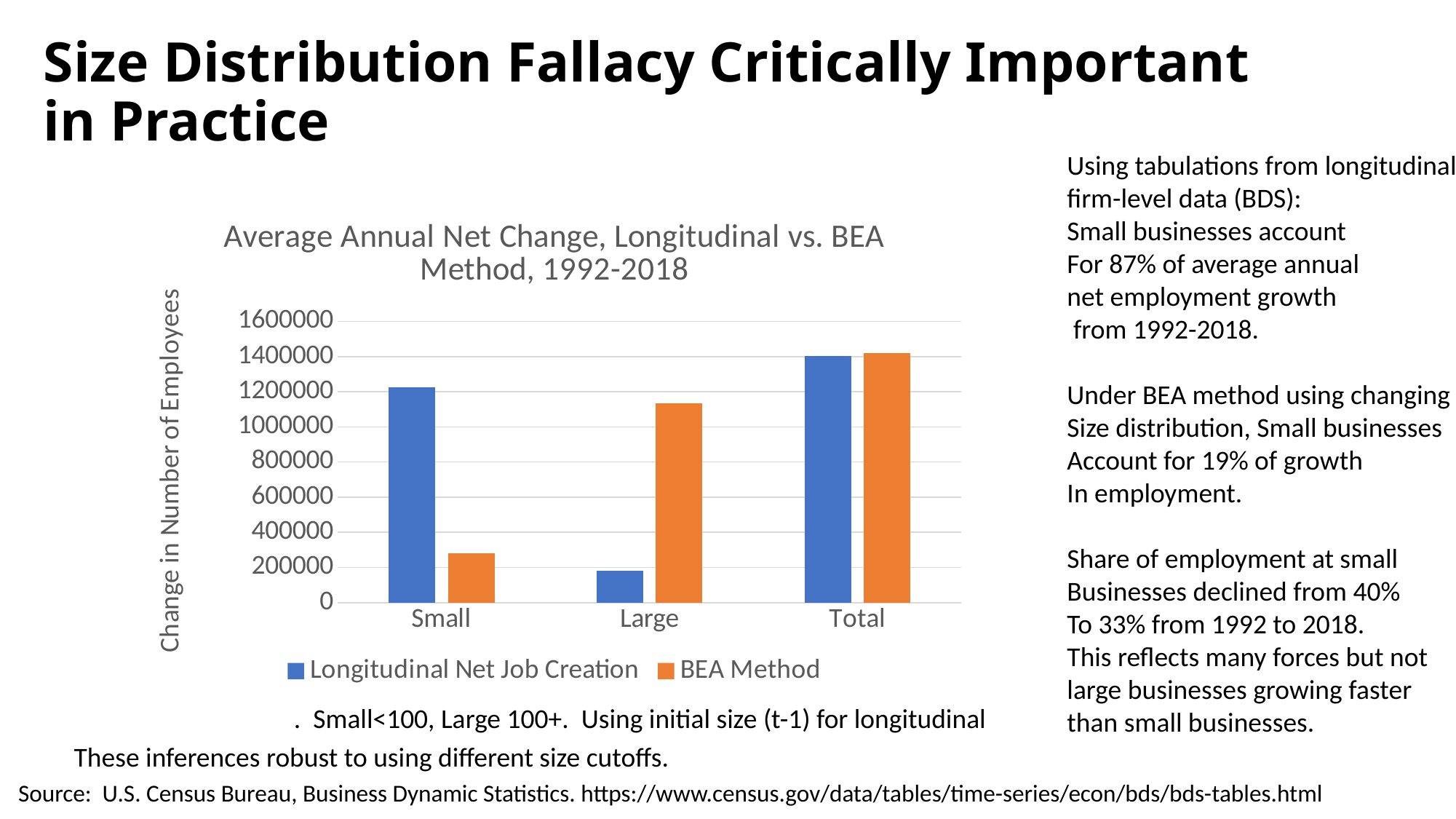
What colour are the bars for the BEA Method series? orange How many series does the chart's legend list? 2 How many categories are shown on the x axis of the chart? 3 For the Large category, which series has the larger value: Longitudinal Net Job Creation or BEA Method? BEA Method What kind of chart is shown on the slide? bar chart For the BEA Method series, which category has the lowest value? Small What is the title of the chart? Average Annual Net Change, Longitudinal vs. BEA Method, 1992-2018 For the Longitudinal Net Job Creation series, which category has the lowest value? Large Is the BEA Method value for Small greater or less than 400000? less For the Longitudinal Net Job Creation series, which category has the highest value? Total For the Small category, which series has the larger value: Longitudinal Net Job Creation or BEA Method? Longitudinal Net Job Creation Is the Longitudinal Net Job Creation value for Small greater or less than 1000000? greater